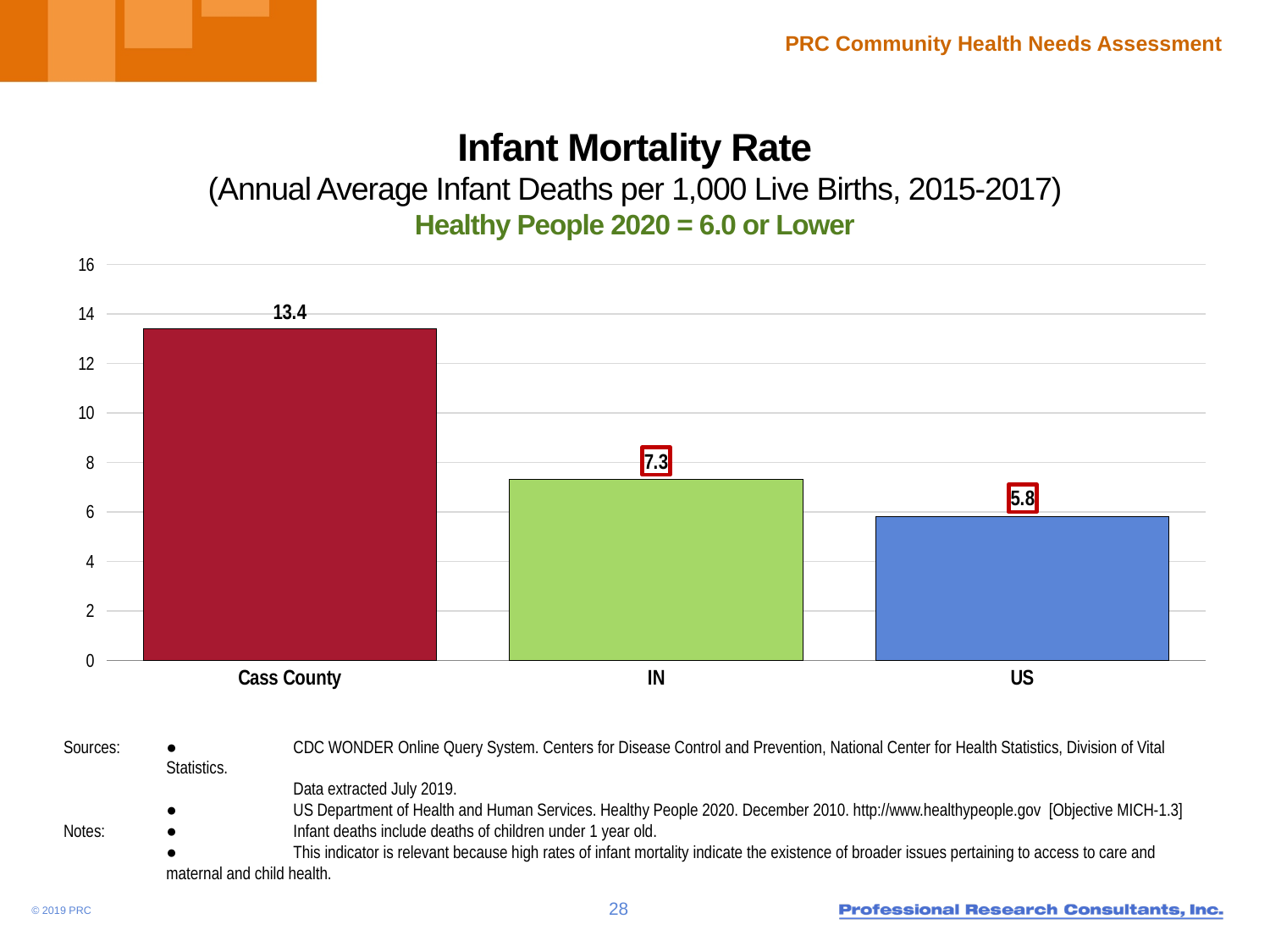
What is the infant mortality rate for IN? 7.3 What is the difference between the infant mortality rate for Cass County and IN? 6.1 What is the infant mortality rate for US? 5.8 What kind of chart is shown on the slide? bar chart What is the infant mortality rate for Cass County? 13.4 Which is larger, the infant mortality rate for IN or for US? IN How many categories are shown in the chart? 3 What is the difference between the infant mortality rate for IN and US? 1.5 Is the value for Cass County greater or less than 12? greater What is the Healthy People 2020 target stated on the slide? 6.0 or Lower Which category has the highest infant mortality rate? Cass County Which category has the lowest infant mortality rate? US